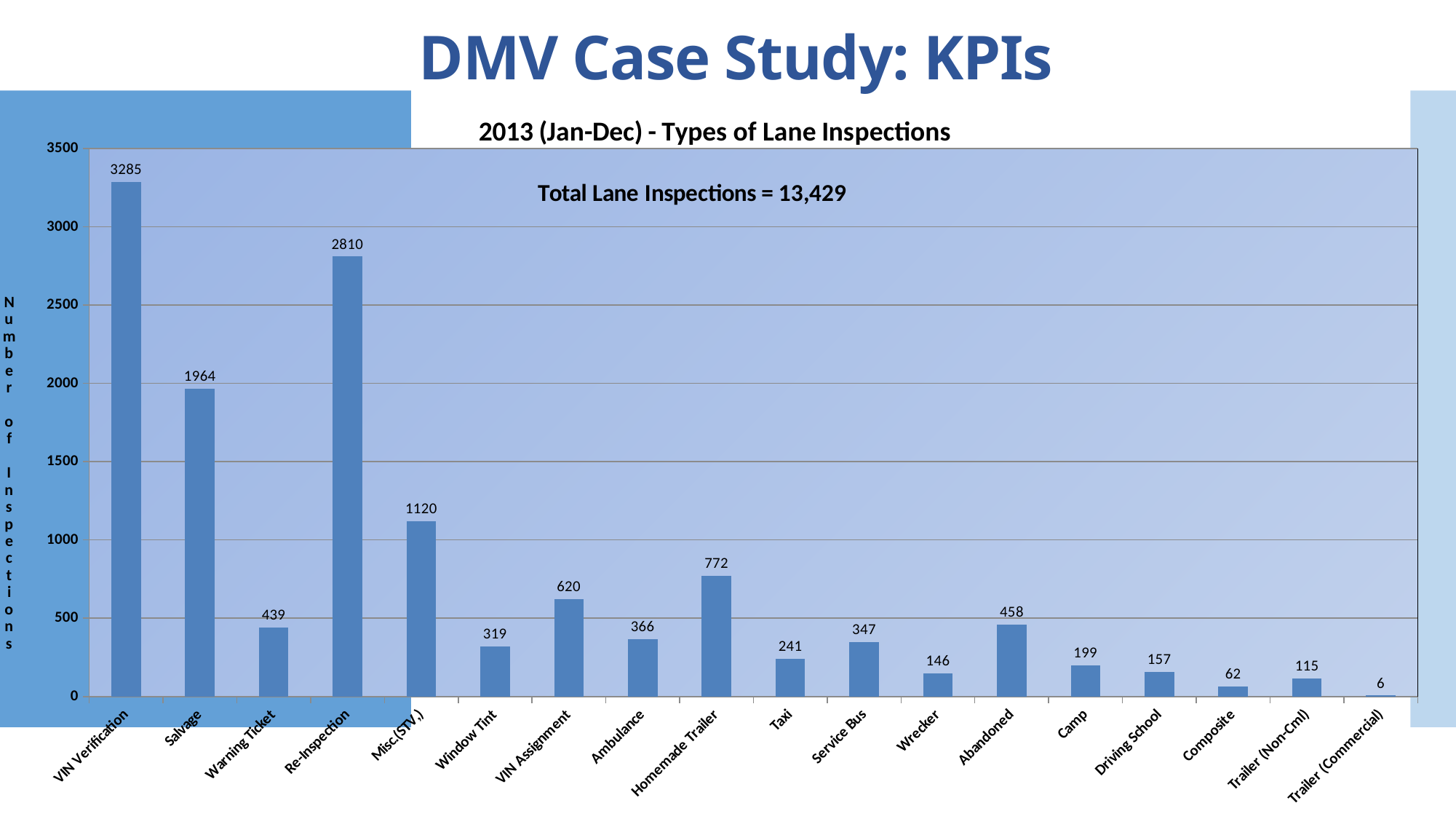
Which type of lane inspection has the lowest number of inspections? Trailer (Commercial) What is the total number of lane inspections stated on the chart? 13,429 Which has more inspections, Abandoned or Warning Ticket? Abandoned What is the number of inspections for Wrecker? 146 Is the value for Misc (STV,) greater or less than 1000? greater Which type of lane inspection has the highest number of inspections? VIN Verification What is the difference between the number of inspections for Re-Inspection and Salvage? 846 What kind of chart is shown on the slide? Bar chart What is the number of inspections for Homemade Trailer? 772 What is the number of inspections for VIN Verification? 3285 What is the title of the chart? 2013 (Jan-Dec) - Types of Lane Inspections How many types of lane inspections are shown on the chart? 18